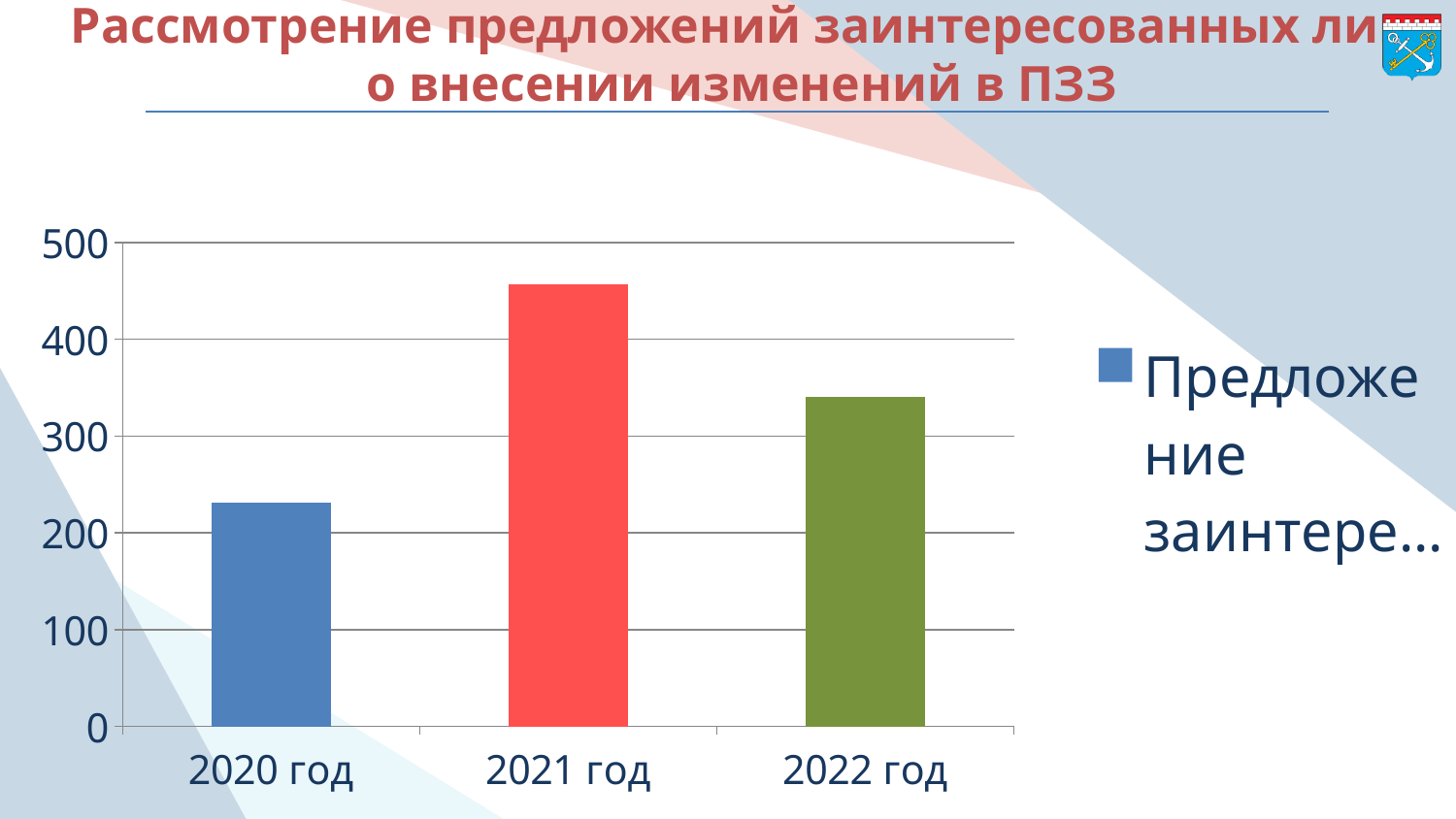
What kind of chart is shown on the slide? Bar chart Which year has the highest bar? 2021 год Is the value for 2021 год greater or less than 500? less Is the value for 2022 год greater or less than 300? greater Is the value for 2021 год greater or less than 400? greater What colour is the bar for 2021 год? Red How many categories (years) are plotted on the x axis? 3 Do the values rise or fall from 2021 год to 2022 год? fall How many series does the legend list? 1 Which year has the lowest bar? 2020 год Which is larger, the value for 2022 год or the value for 2020 год? 2022 год